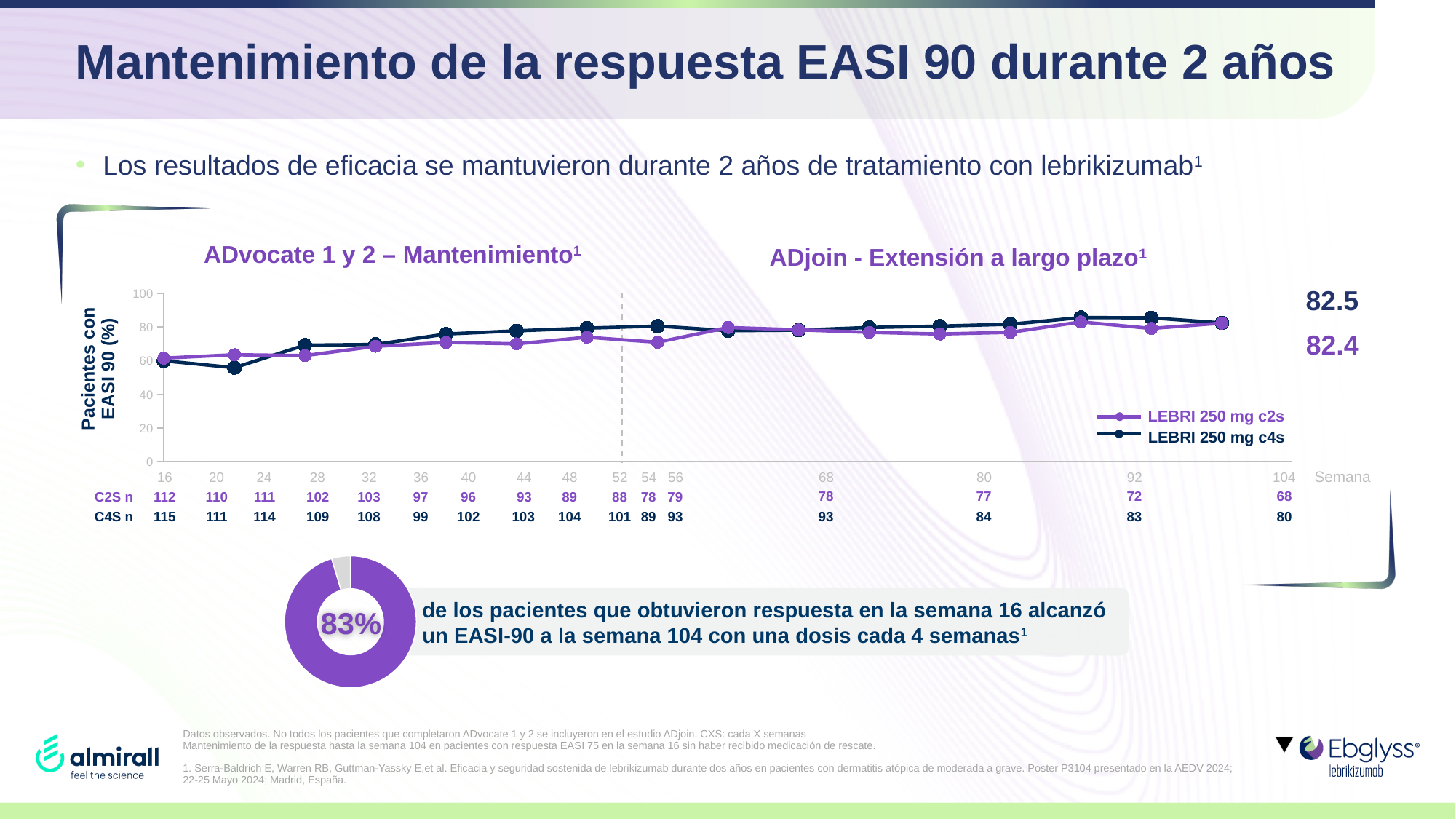
In the line chart, is the value for LEBRI 250 mg c4s at week 16 greater or less than 80? less In the line chart, what is the difference between the week 104 values of LEBRI 250 mg c4s and LEBRI 250 mg c2s? 0.1 What is the y-axis label of the line chart? Pacientes con EASI 90 (%) In the line chart, is the value for LEBRI 250 mg c2s at week 92 greater or less than 60? greater In the line chart, which series has the higher value at week 104, LEBRI 250 mg c2s or LEBRI 250 mg c4s? LEBRI 250 mg c4s What kind of chart is the main chart showing patients with EASI 90 over weeks? line chart Which series in the line chart is drawn in purple? LEBRI 250 mg c2s What share of patients does the donut chart highlight? 83% In the line chart, do the values for LEBRI 250 mg c2s generally rise or fall from week 16 to week 104? rise In the line chart, what is the value for LEBRI 250 mg c4s at week 104? 82.5 How many series does the legend of the line chart list? 2 In the line chart, what is the value for LEBRI 250 mg c2s at week 104? 82.4